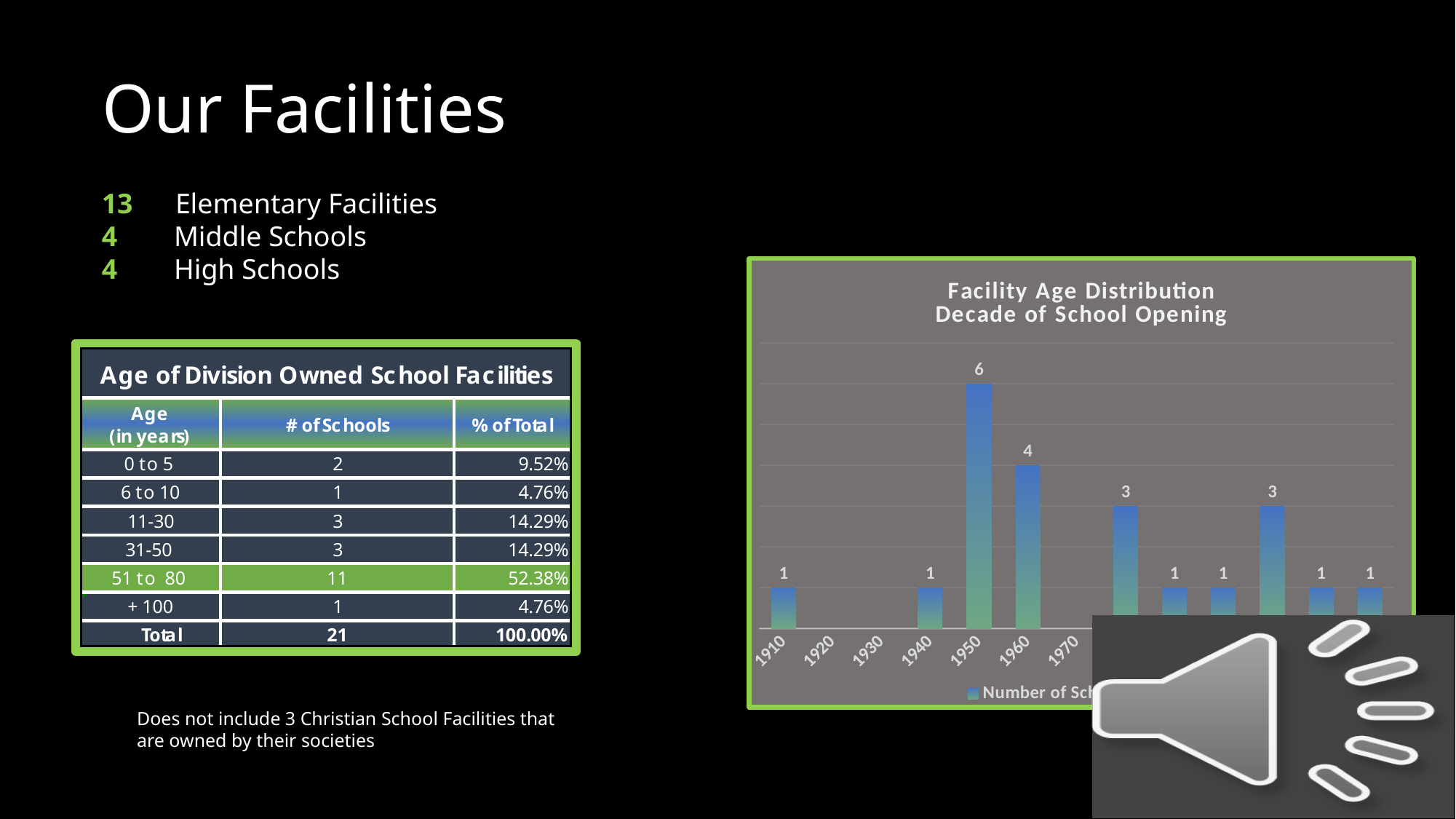
What is the title of the chart on the right of the slide? Facility Age Distribution Decade of School Opening In the Facility Age Distribution chart, which is larger, the value for 1940 or the value for 1960? 1960 In the Facility Age Distribution chart, what is the value for 1940? 1 In the Facility Age Distribution chart, which decade has the highest number of schools? 1950 In the Facility Age Distribution chart, what is the value for 1960? 4 In the Facility Age Distribution chart, what is the difference between the values for 1950 and 1960? 2 What kind of chart is the Facility Age Distribution chart? bar chart In the Facility Age Distribution chart, how many schools opened in the 1950 decade? 6 In the Facility Age Distribution chart, which is larger, the value for 1950 or the value for 1960? 1950 In the Facility Age Distribution chart, what is the value for 1910? 1 How many bars are plotted in the Facility Age Distribution chart? 10 In the Facility Age Distribution chart, how much greater is the value for 1950 than the value for 1910? 5